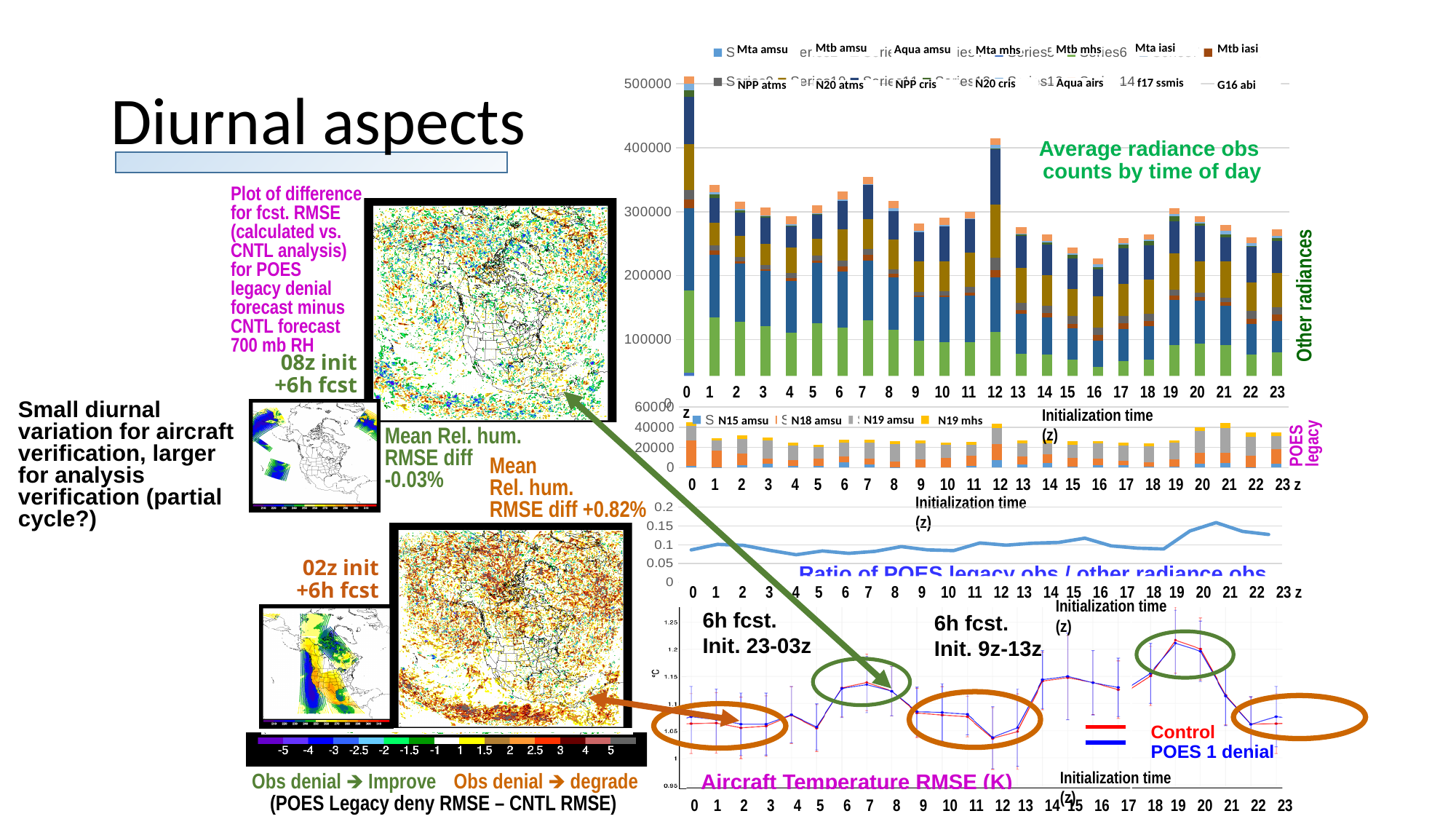
In the 'Average radiance obs counts by time of day' chart, is the total for initialization time 16 greater or less than 300000? less In the 'POES legacy' bar chart, is the total for initialization time 16 greater or less than 40000? less In the 'Average radiance obs counts by time of day' chart, is the total for initialization time 0 greater or less than 400000? greater What kind of chart is the 'Average radiance obs counts by time of day' chart? bar chart How many series does the legend of the 'POES legacy' bar chart list? 4 In the 'Aircraft Temperature RMSE (K)' chart, what colour is the Control series? red In the 'Average radiance obs counts by time of day' chart, how many initialization times are shown on the x axis? 24 In the 'Average radiance obs counts by time of day' chart, which total is larger, initialization time 0 or initialization time 16? 0 In the 'Average radiance obs counts by time of day' chart, which initialization time has the highest total obs count? 0 In the 'Aircraft Temperature RMSE (K)' chart, how many series does the legend list? 2